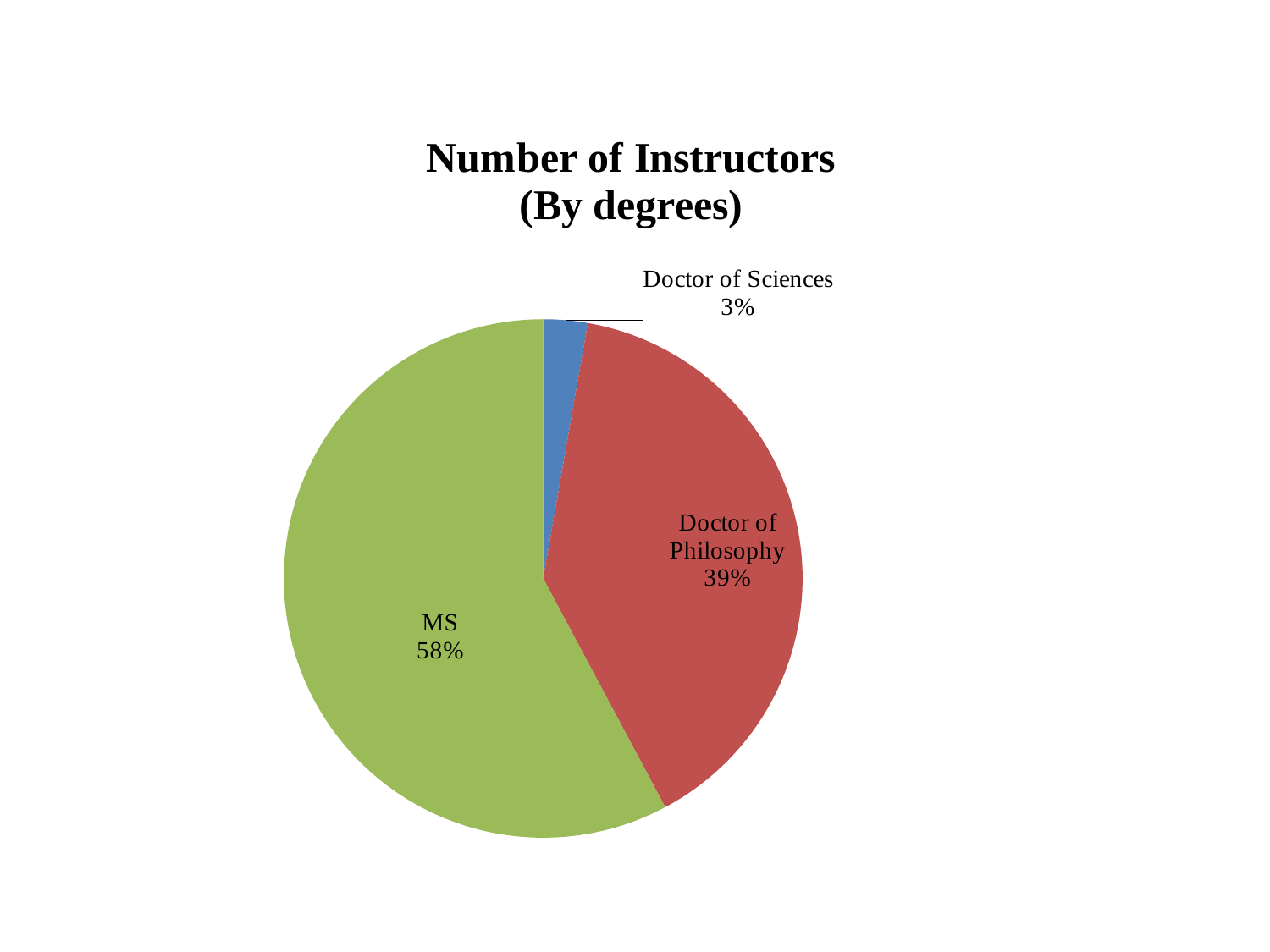
Which degree category has the largest share of instructors? MS What share of instructors hold an MS degree? 58% What is the title of the chart? Number of Instructors (By degrees) What type of chart is shown on the slide? pie chart What share of instructors hold a Doctor of Sciences degree? 3% Which degree category has the smallest share of instructors? Doctor of Sciences What is the difference in percentage points between the Doctor of Philosophy share and the Doctor of Sciences share? 36 How many degree categories are shown in the pie chart? 3 Which is larger, the share for MS or the share for Doctor of Philosophy? MS What is the difference in percentage points between the MS share and the Doctor of Philosophy share? 19 What share of instructors hold a Doctor of Philosophy degree? 39% What colour is the slice representing MS? green